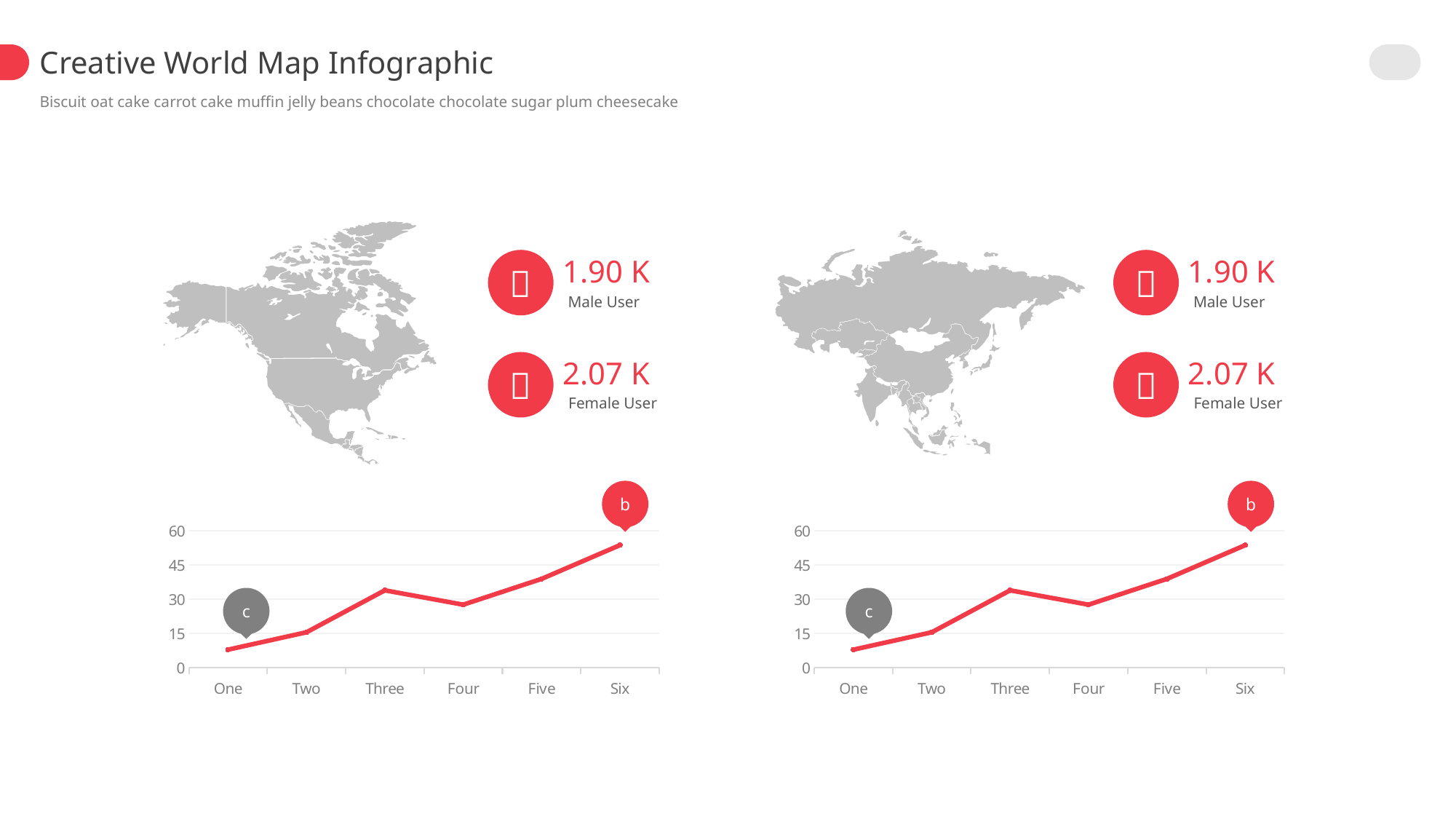
In the left line chart, which category has the lowest value? One In the left line chart, which is larger, the value for Three or the value for Four? Three In the right line chart below the Asia map, do the values generally rise or fall from One to Six? rise How many categories are on the x axis of the left line chart? 6 What is the highest tick value shown on the y axis of the right line chart? 60 In the left line chart, is the value for One greater or less than 15? less What kind of chart is the left chart below the North America map? line chart In the left line chart, is the value for Six greater or less than 45? greater In the left line chart, which category has the highest value? Six In the right line chart, is the value for Five greater or less than 30? greater In the right line chart, which category has the highest value? Six What colour is the line in the left line chart? red